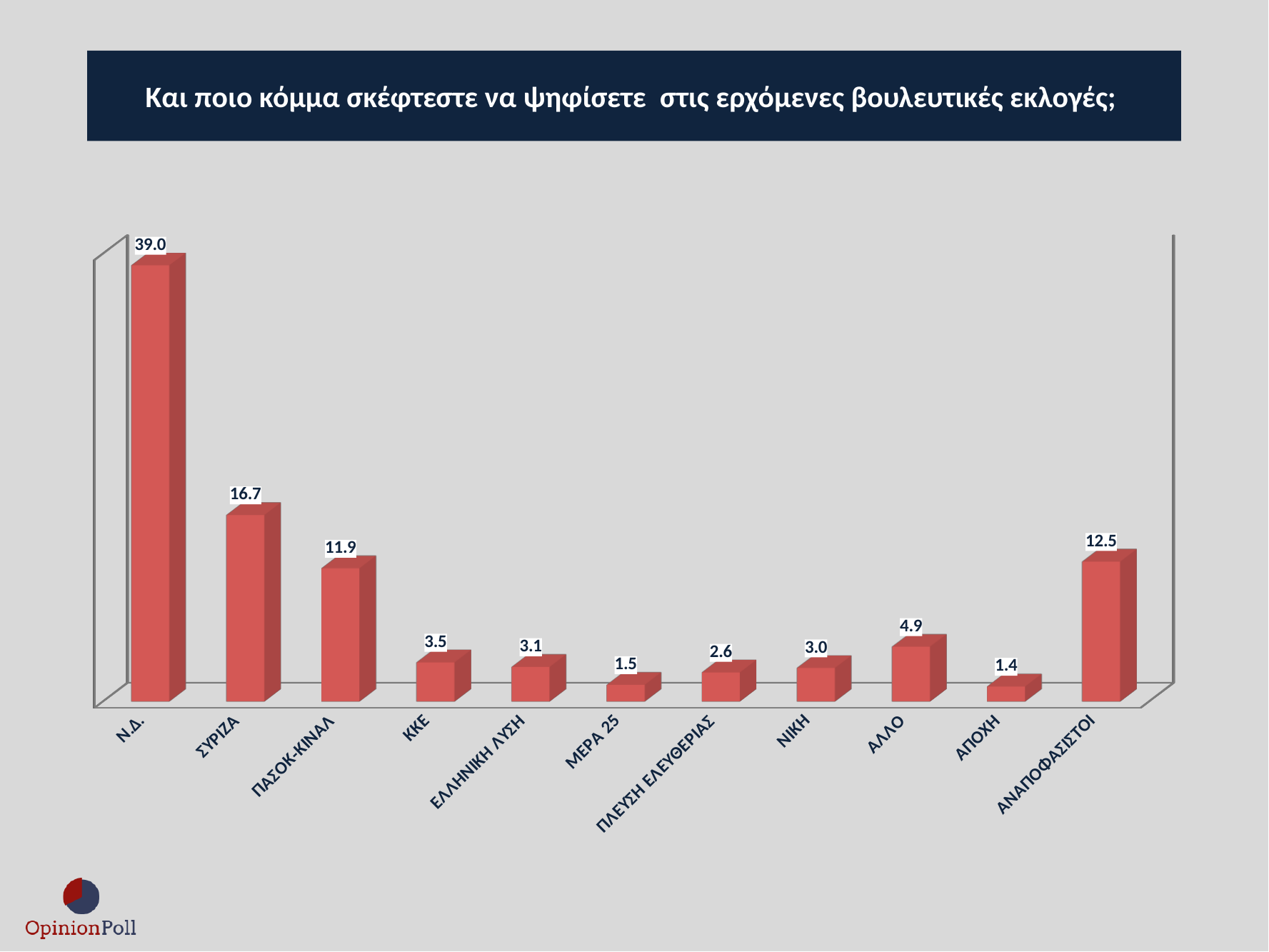
What is the value for ΑΝΑΠΟΦΑΣΙΣΤΟΙ? 12.5 What is the value for Ν.Δ.? 39.0 What is the difference between the values for ΠΑΣΟΚ-ΚΙΝΑΛ and ΚΚΕ? 8.4 Which category has the lowest value? ΑΠΟΧΗ How many categories are shown on the x axis? 11 What is the value for ΠΛΕΥΣΗ ΕΛΕΥΘΕΡΙΑΣ? 2.6 What is the value for ΣΥΡΙΖΑ? 16.7 What colour are the bars in the chart? red Which is larger, the value for ΑΛΛΟ or the value for ΝΙΚΗ? ΑΛΛΟ Which category has the highest value? Ν.Δ. What is the difference between the values for Ν.Δ. and ΣΥΡΙΖΑ? 22.3 What kind of chart is shown on the slide? bar chart